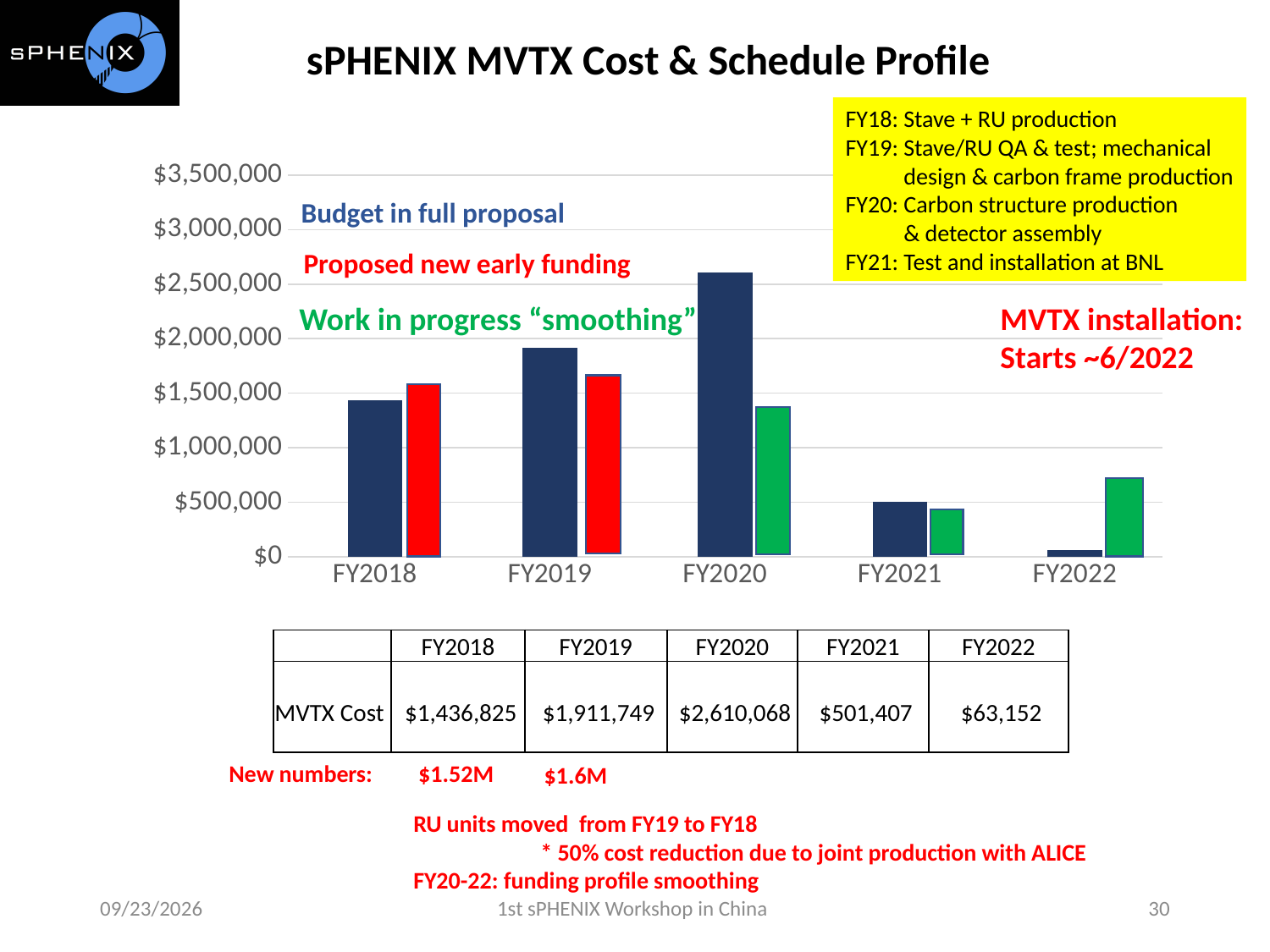
Which fiscal year has the lowest budget in full proposal? FY2022 Which is larger, the budget in full proposal for FY2021 or for FY2022? FY2021 How many fiscal years are shown on the x axis of the chart? 5 What kind of chart is shown on the slide? bar chart What colour are the 'Proposed new early funding' bars in the chart? red Is the value of the green 'work in progress smoothing' bar for FY2020 greater or less than $1,500,000? less What is the MVTX Cost (budget in full proposal) for FY2022? $63,152 What is the difference between the FY2019 and FY2018 MVTX Cost values in the table? $474,924 Which fiscal year has the highest budget in full proposal? FY2020 Is the value of the green 'work in progress smoothing' bar for FY2022 greater or less than $500,000? greater What is the MVTX Cost (budget in full proposal) for FY2020? $2,610,068 What is the new number given for FY2018 proposed early funding? $1.52M